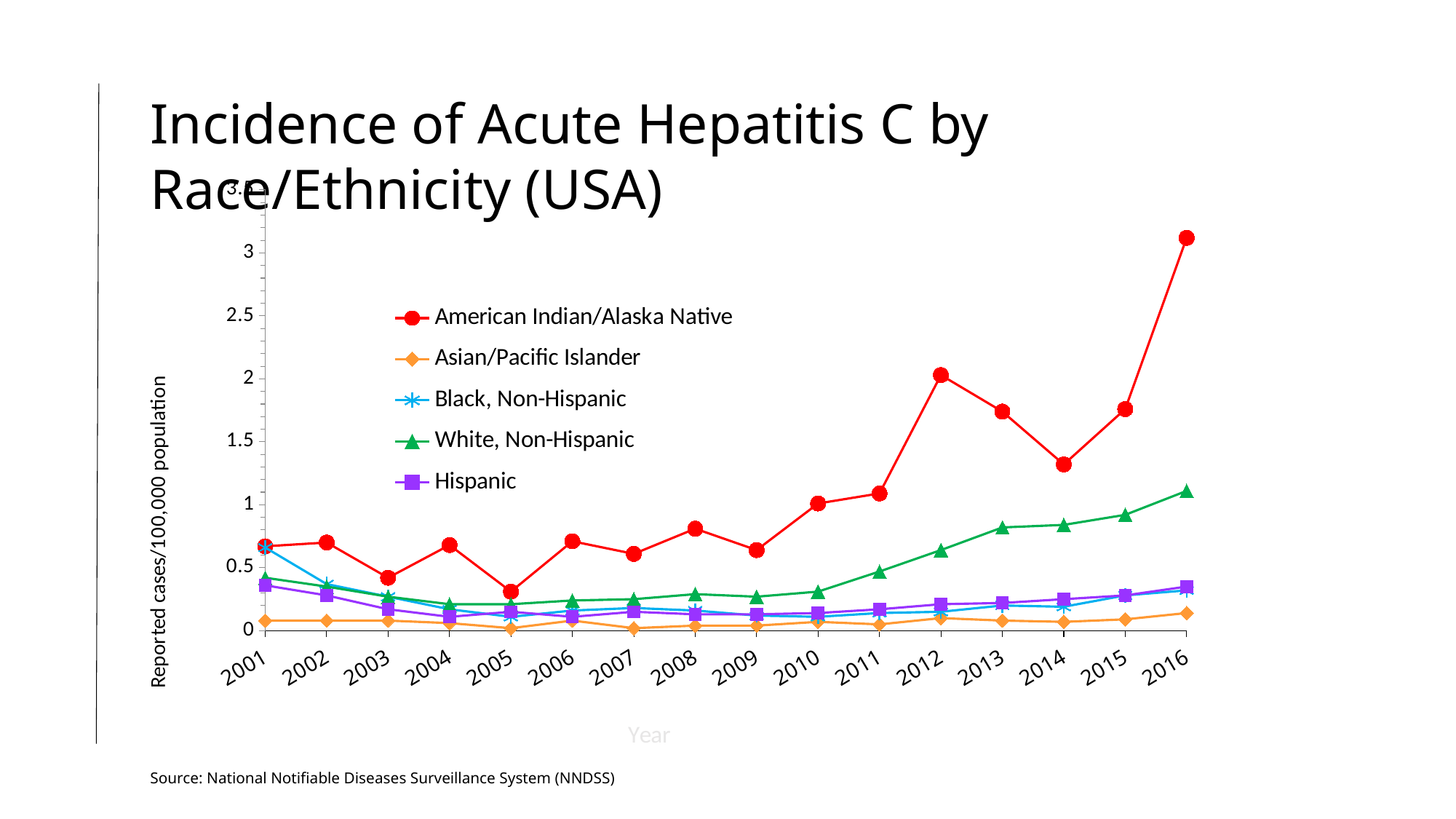
Which race/ethnicity group has the lowest incidence in 2016? Asian/Pacific Islander In which year does the American Indian/Alaska Native series reach its lowest value? 2005 Is the value for White, Non-Hispanic in 2016 greater or less than 1? greater How many series does the legend list? 5 In which year does the American Indian/Alaska Native series reach its highest value? 2016 What kind of chart is shown on the slide? Line chart Which race/ethnicity group has the highest incidence in 2016? American Indian/Alaska Native Does the White, Non-Hispanic series rise or fall from 2010 to 2016? Rise In 2016, which is larger: the value for White, Non-Hispanic or the value for Hispanic? White, Non-Hispanic How many years are plotted along the x axis? 16 Is the value for American Indian/Alaska Native in 2016 greater or less than 3? greater